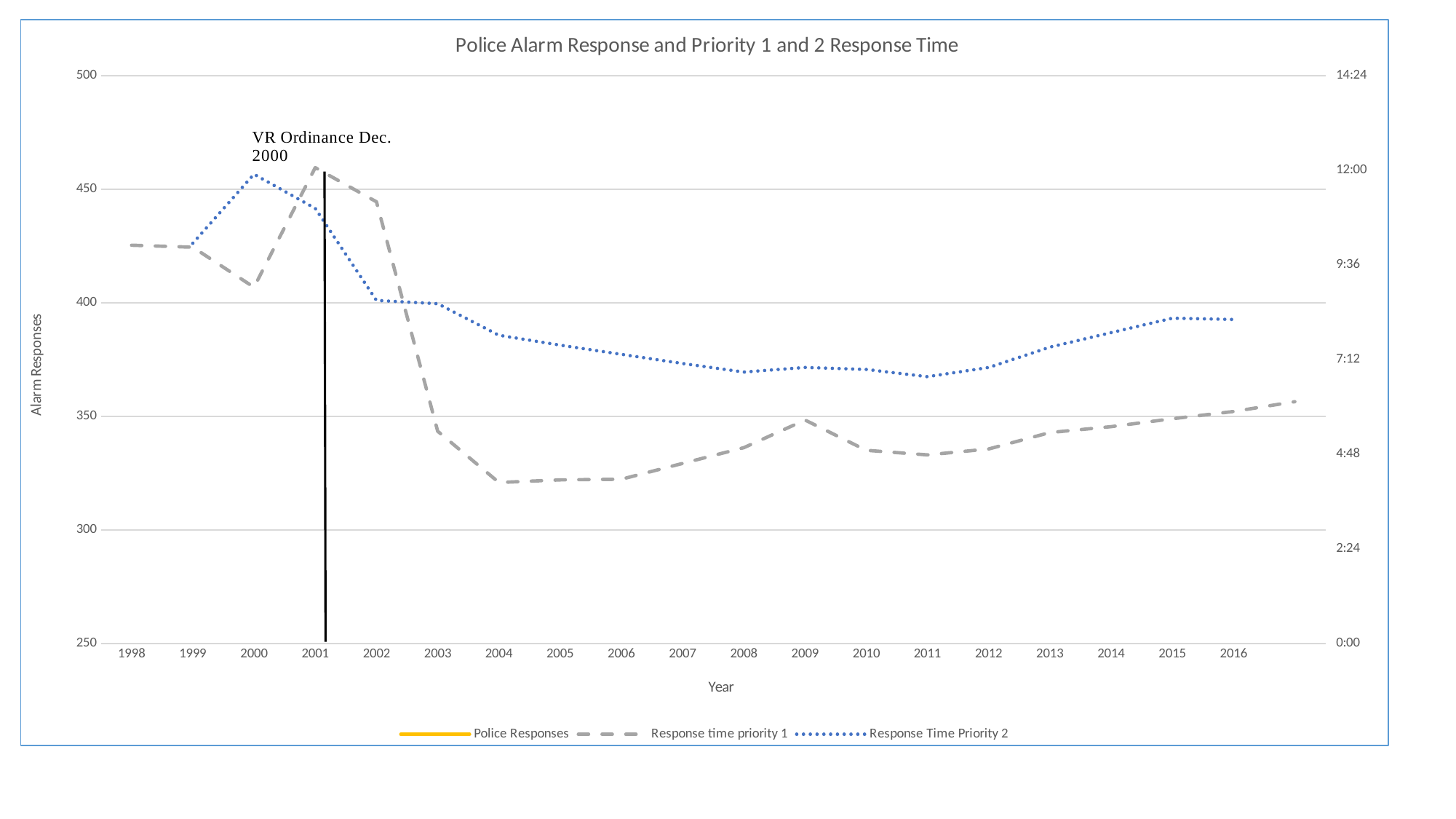
Does the Response time priority 1 line rise or fall from 2001 to 2004? Fall In 2004, which line is higher: Response time priority 1 or Response Time Priority 2? Response Time Priority 2 Is the Response Time Priority 2 value for 2011 greater or less than 400 on the left axis? less How many years are labelled on the x axis? 19 Is the Response Time Priority 2 value for 2000 greater or less than 450 on the left axis? greater Does the Response Time Priority 2 line rise or fall from 2011 to 2016? Rise What event does the annotation next to the vertical black line mark? VR Ordinance Dec. 2000 What kind of chart is shown on the slide? Line chart In which year does the Response time priority 1 line reach its highest point? 2001 In which year does the Response Time Priority 2 line reach its highest point? 2000 Is the Response time priority 1 value for 2004 greater or less than 350 on the left axis? less How many series does the legend list? 3